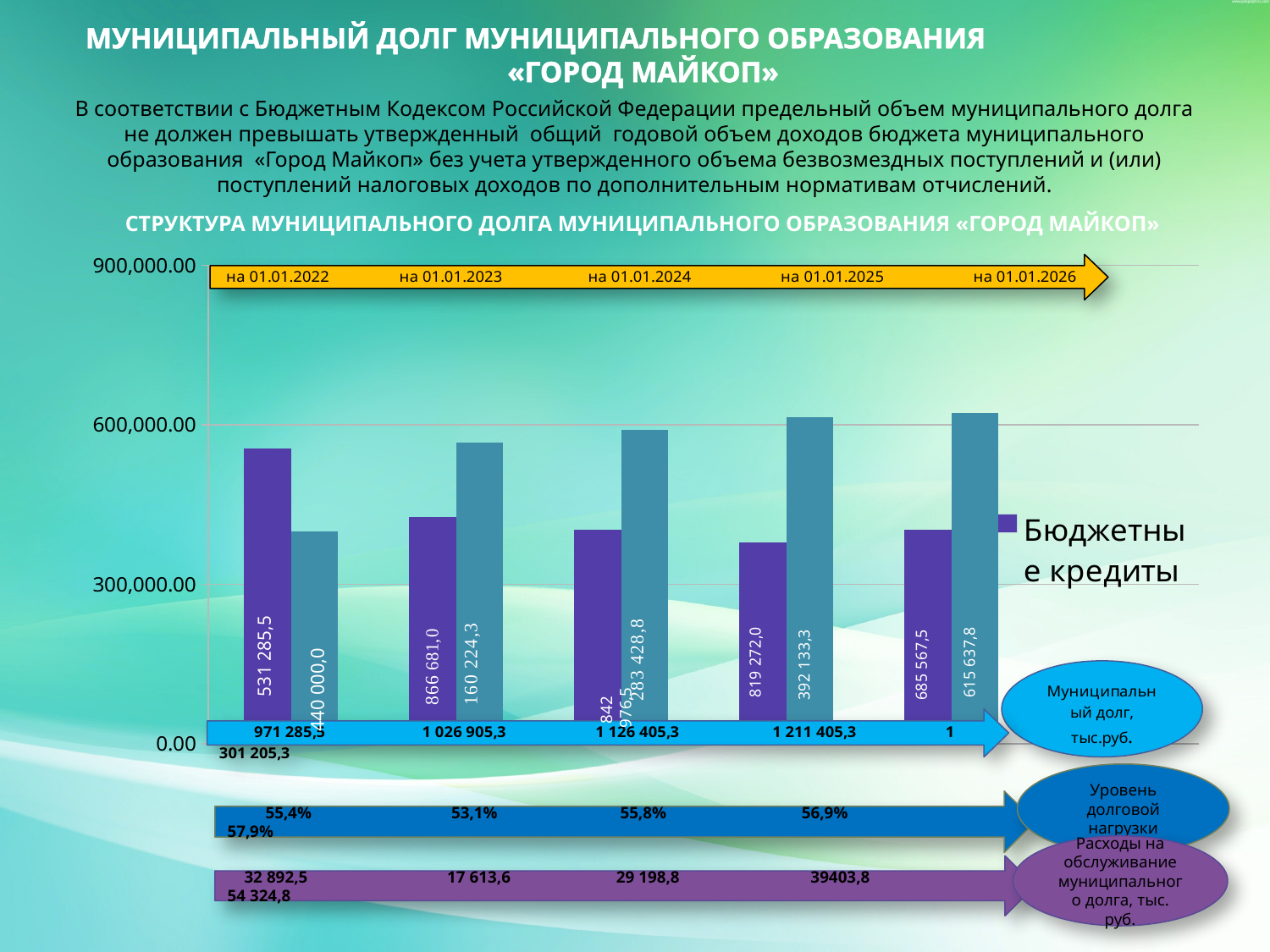
On which date are the Расходы на обслуживание муниципального долга the lowest? на 01.01.2023 What is the value of Бюджетные кредиты на 01.01.2022? 531 285,5 How many dates are shown along the x axis of the chart? 5 Does the Муниципальный долг rise or fall from 01.01.2022 to 01.01.2026? rises What is the Уровень долговой нагрузки на 01.01.2025? 56,9% What is the value of Бюджетные кредиты на 01.01.2026? 685 567,5 On which date is the Уровень долговой нагрузки the highest? на 01.01.2026 What kind of chart is shown on the slide? bar chart What is the Муниципальный долг (тыс.руб.) на 01.01.2024? 1 126 405,3 What are the Расходы на обслуживание муниципального долга на 01.01.2023? 17 613,6 By how many percentage points does the Уровень долговой нагрузки на 01.01.2026 exceed that на 01.01.2022? 2,5% What series name is shown in the chart legend? Бюджетные кредиты